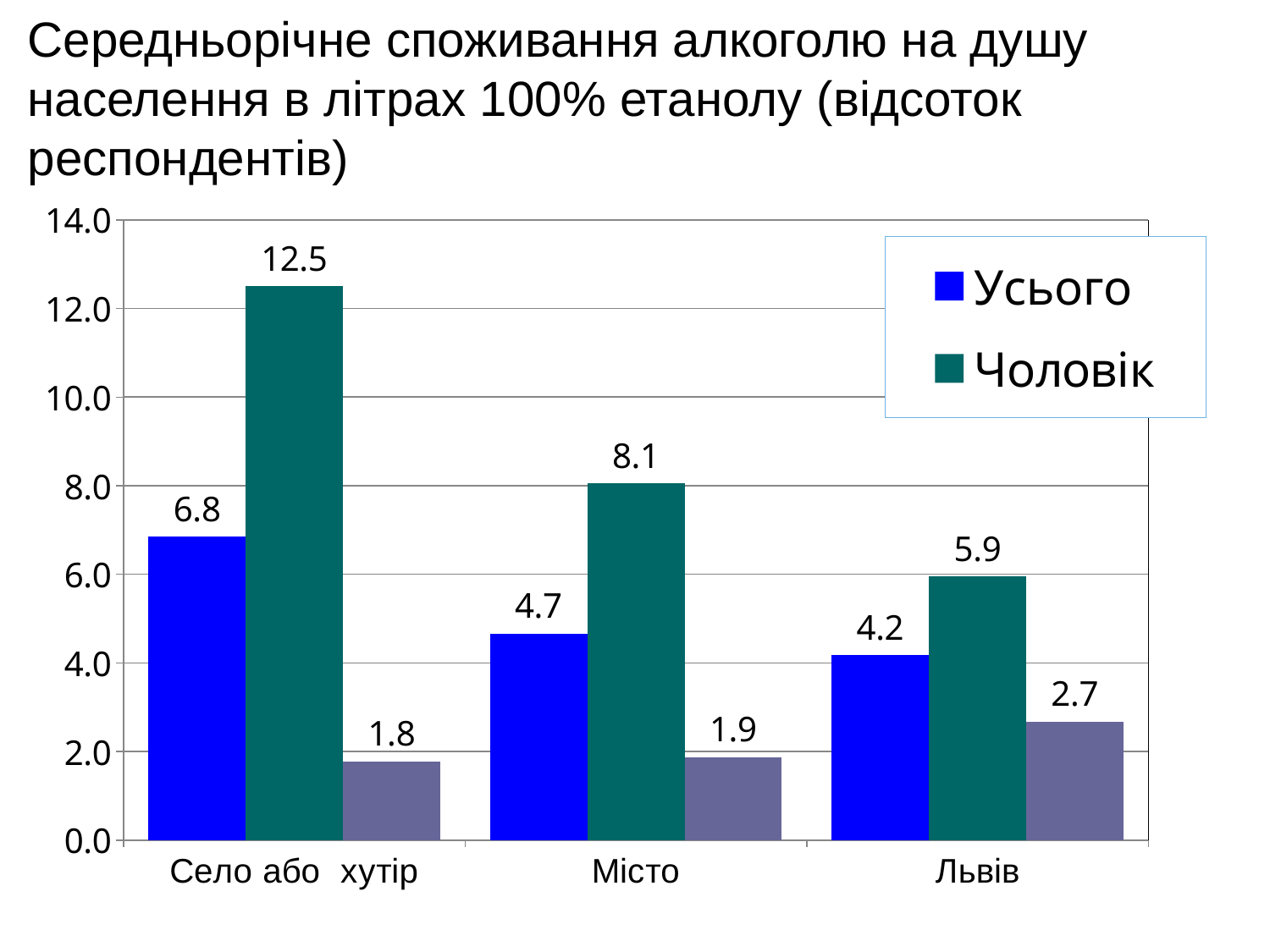
Do the Усього values rise or fall from Село або хутір to Львів? Fall What is the value of Чоловік for Село або хутір? 12.5 What kind of chart is shown on the slide? Bar chart Which has a larger Усього value, Місто or Львів? Місто What is the value of Усього for Місто? 4.7 What is the value of Усього for Львів? 4.2 What is the difference between the Чоловік values for Місто and Львів? 2.2 Which category has the highest Чоловік value? Село або хутір How many categories are shown on the x axis? 3 What is the value of Чоловік for Львів? 5.9 Which category has the lowest Усього value? Львів What is the difference between the Чоловік and Усього values for Село або хутір? 5.7